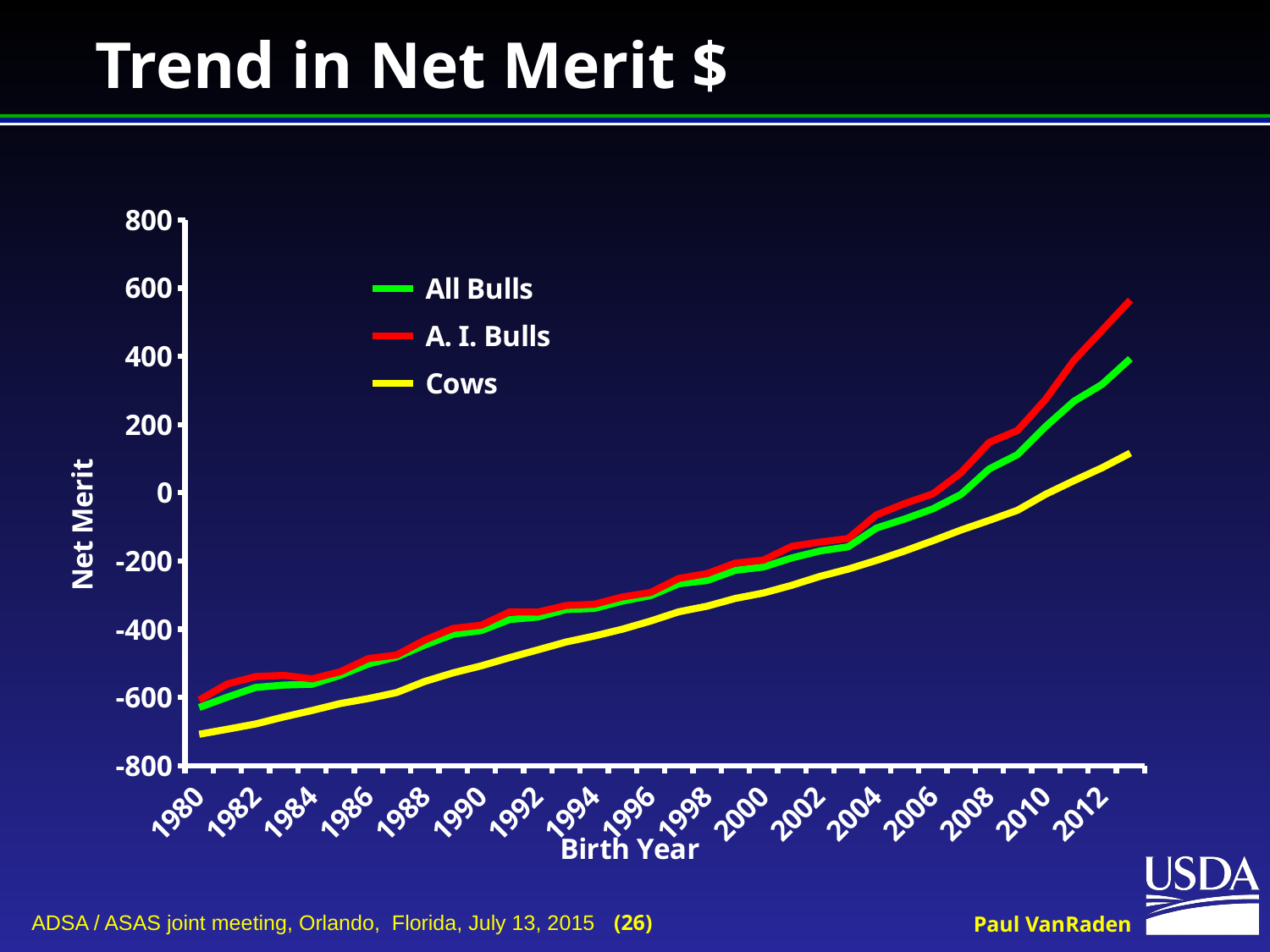
In 2010, which series has the higher Net Merit, A. I. Bulls or Cows? A. I. Bulls Do the Net Merit values for A. I. Bulls rise or fall as birth year increases? rise What is the title of the chart? Trend in Net Merit $ Is the Net Merit value for A. I. Bulls in 2012 greater or less than 400? greater Is the Net Merit value for Cows in 1980 greater or less than -600? less Is the Net Merit value for Cows in 2012 greater or less than 0? greater Which series is drawn in yellow? Cows What kind of chart is shown on the slide? line chart How many series does the legend list? 3 Which series has the lowest Net Merit across the whole period shown? Cows